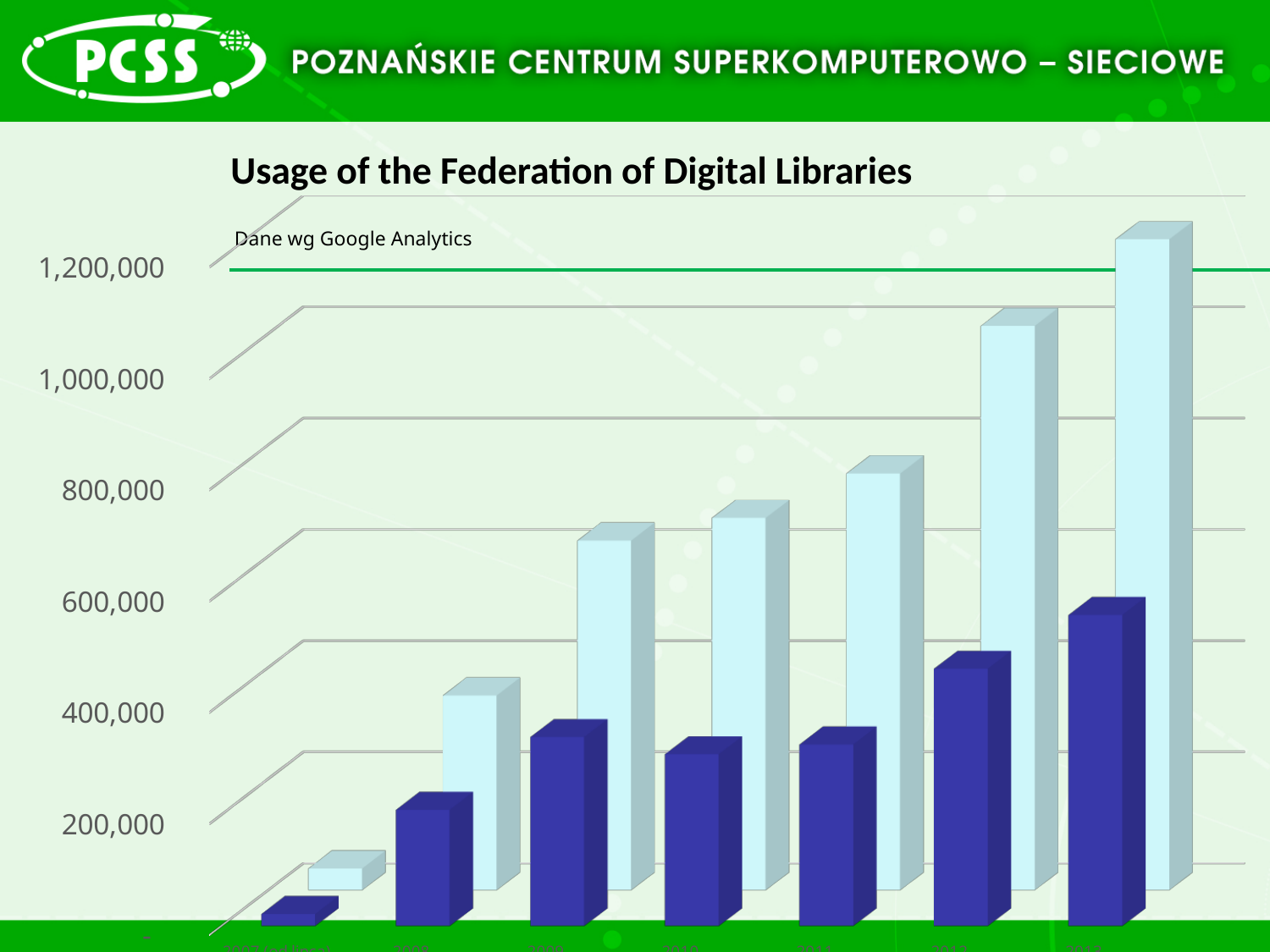
Is the value of the leftmost light blue bar greater or less than 200,000? less How many categories (groups of bars) are plotted along the x axis? 7 Which category has the shortest dark blue bar? the leftmost (first) category Which category has the tallest light blue bar? the rightmost (last) category How many bars are shown for each category on the chart? 2 Do the light blue bars rise or fall from left to right along the x axis? rise What is the title of the chart on the slide? Usage of the Federation of Digital Libraries What kind of chart is shown on the slide? bar chart Is the value of the rightmost dark blue bar greater or less than 600,000? less Which is larger in the rightmost category: the light blue bar or the dark blue bar? the light blue bar